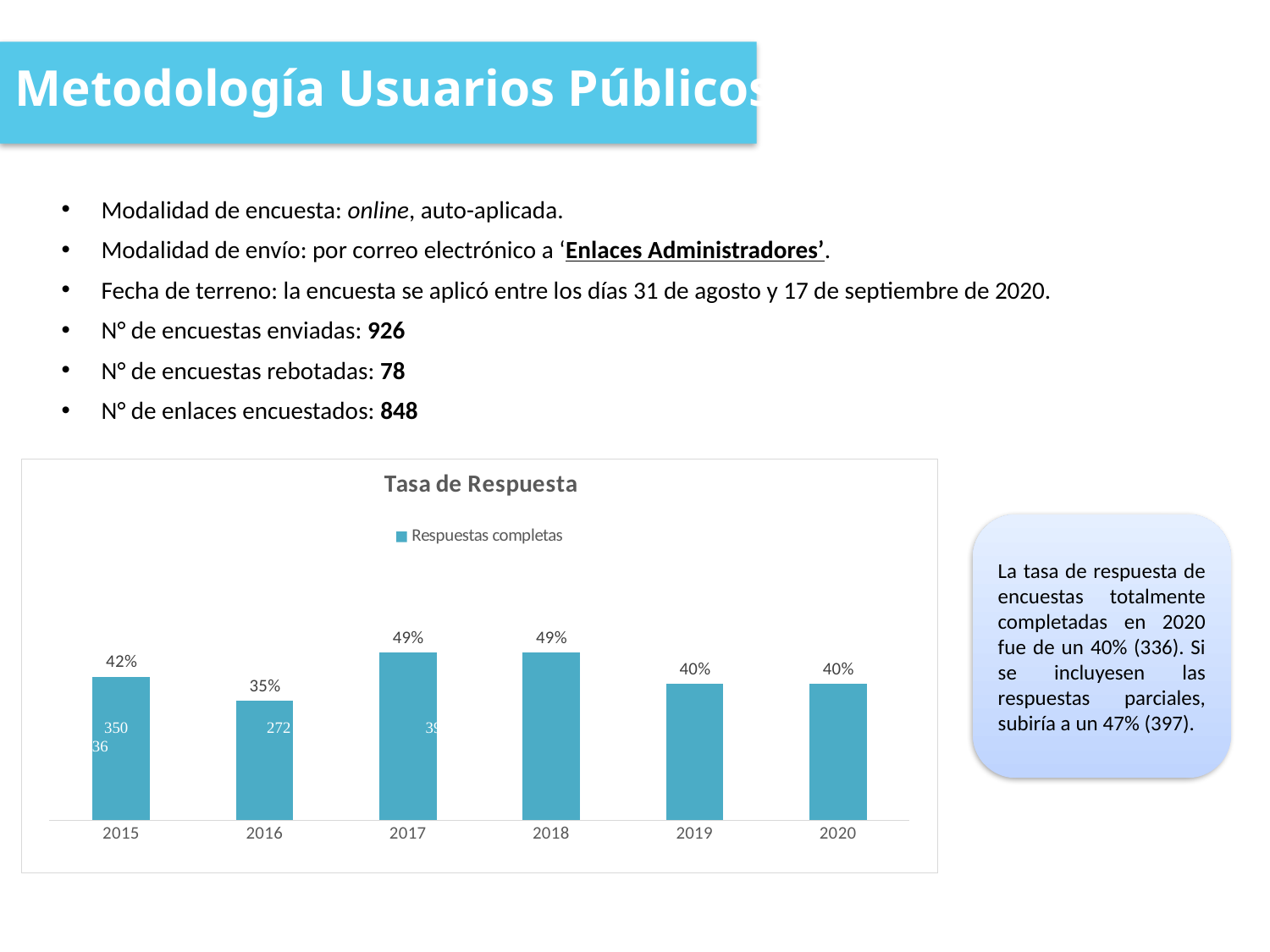
What is the response rate shown for 2020? 40% What kind of chart is shown on the slide? Bar chart How many series does the chart legend list? 1 Which year has a higher response rate, 2015 or 2016? 2015 What is the difference in percentage points between the response rates for 2017 and 2016? 14 Did the response rate rise or fall from 2018 to 2019? Fall What is the response rate shown for 2016? 35% What is the title of the chart? Tasa de Respuesta Which year has the lowest response rate in the chart? 2016 What is the response rate shown for 2018? 49% What is the response rate shown for 2015 in the Tasa de Respuesta chart? 42% How many years are shown on the x axis of the chart? 6